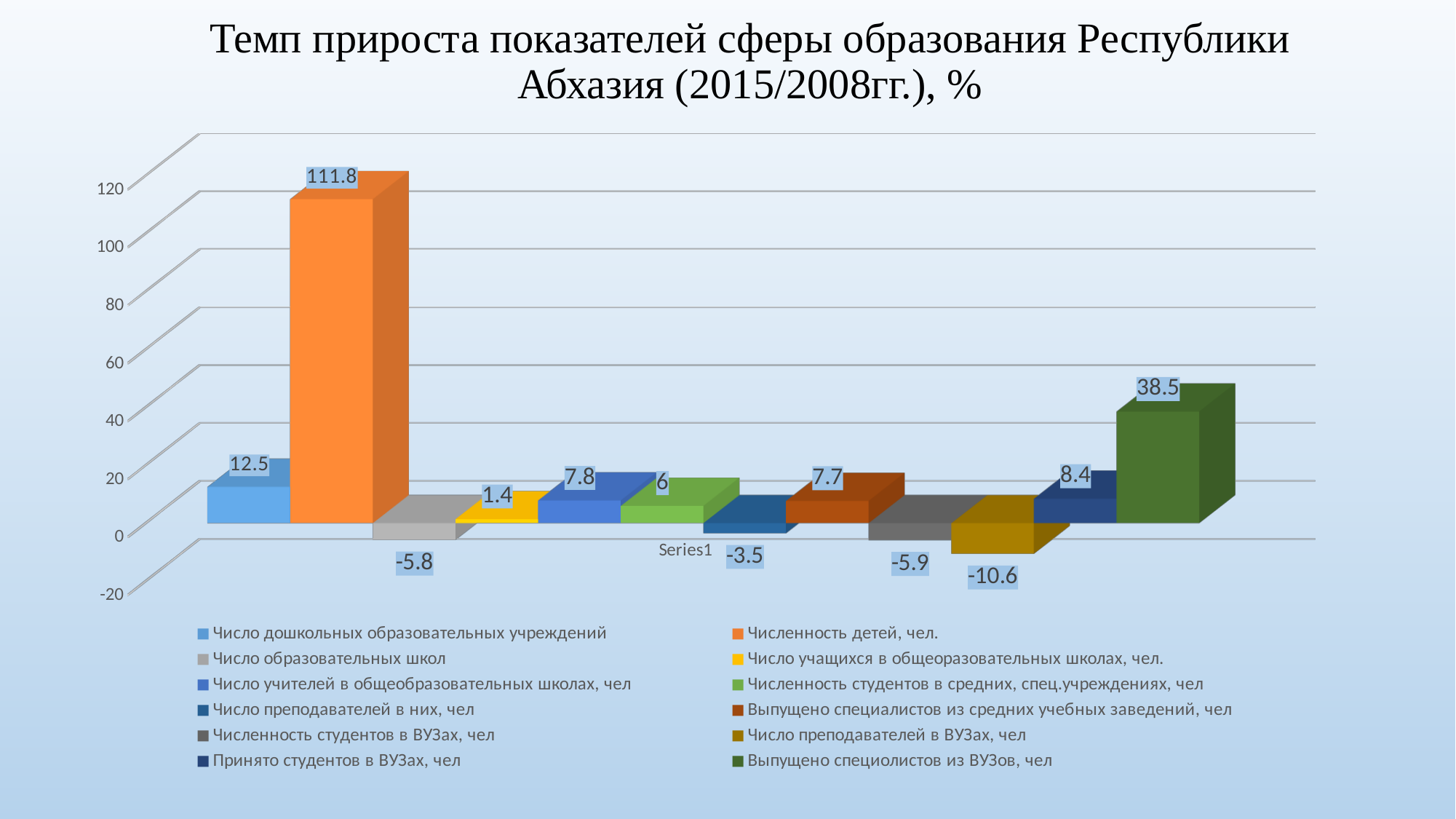
Which is larger: the value for Число дошкольных образовательных учреждений or the value for Принято студентов в ВУЗах, чел? Число дошкольных образовательных учреждений What is the value for Выпущено специолистов из ВУЗов, чел? 38.5 Which series has the highest value? Численность детей, чел. How many series does the legend list? 12 What is the value for Число преподавателей в ВУЗах, чел? -10.6 What kind of chart is shown on the slide? Bar chart What is the value for Численность детей, чел.? 111.8 What is the title of the chart? Темп прироста показателей сферы образования Республики Абхазия (2015/2008гг.), % What is the value for Число образовательных школ? -5.8 What is the difference between the values for Численность детей, чел. and Выпущено специолистов из ВУЗов, чел? 73.3 Is the value for Численность детей, чел. greater or less than 100? greater Which series has the lowest value? Число преподавателей в ВУЗах, чел